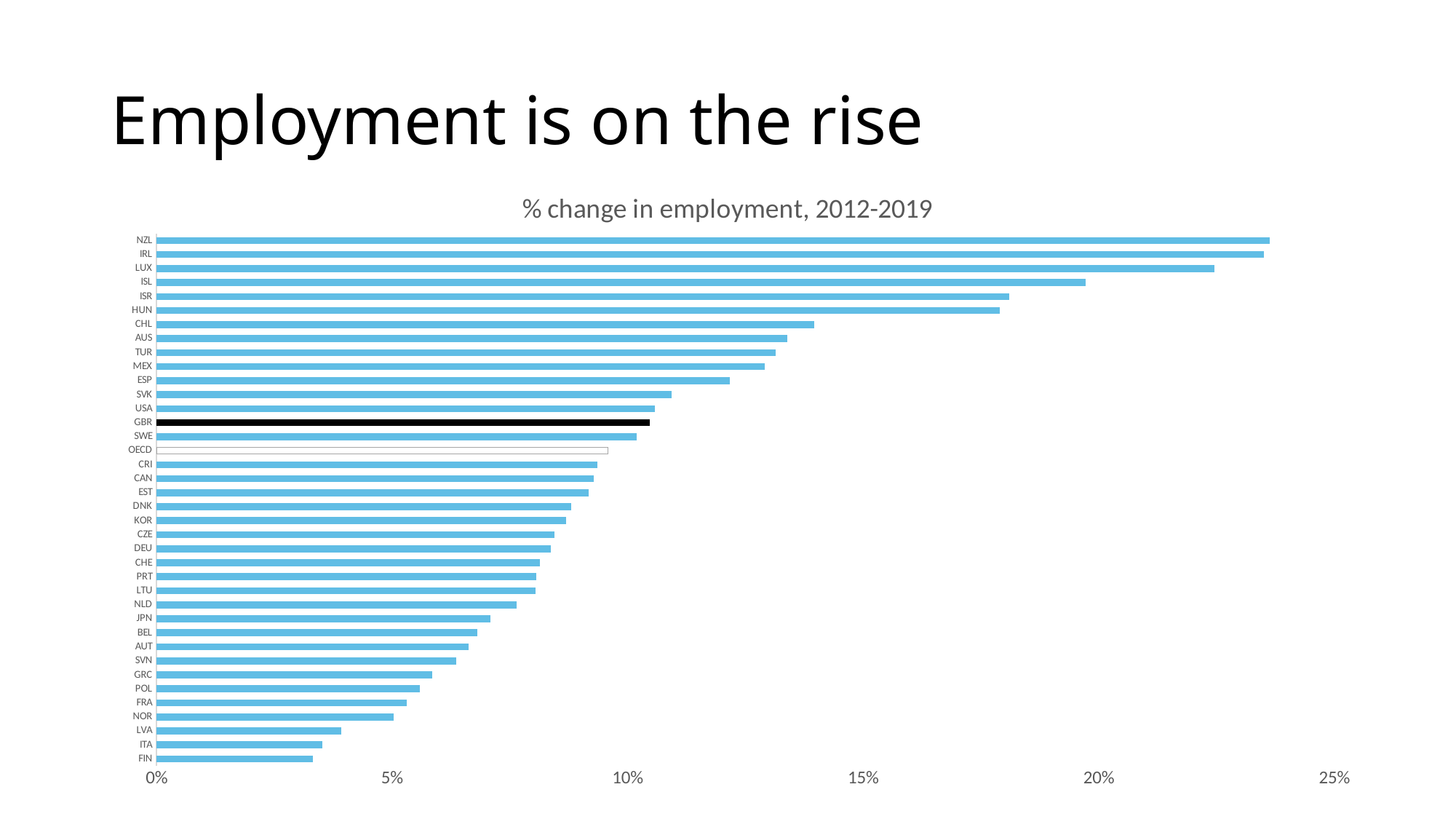
Is the value for GBR greater or less than 10%? greater What kind of chart is shown on the slide? bar chart Is the value for OECD greater or less than 10%? less How many countries/categories are plotted in the chart? 38 Is the value for FIN greater or less than 5%? less What is the title of the chart? % change in employment, 2012-2019 Which bar is coloured black instead of blue? GBR Which has the larger value, CHL or AUS? CHL Which has the larger value, GBR or OECD? GBR